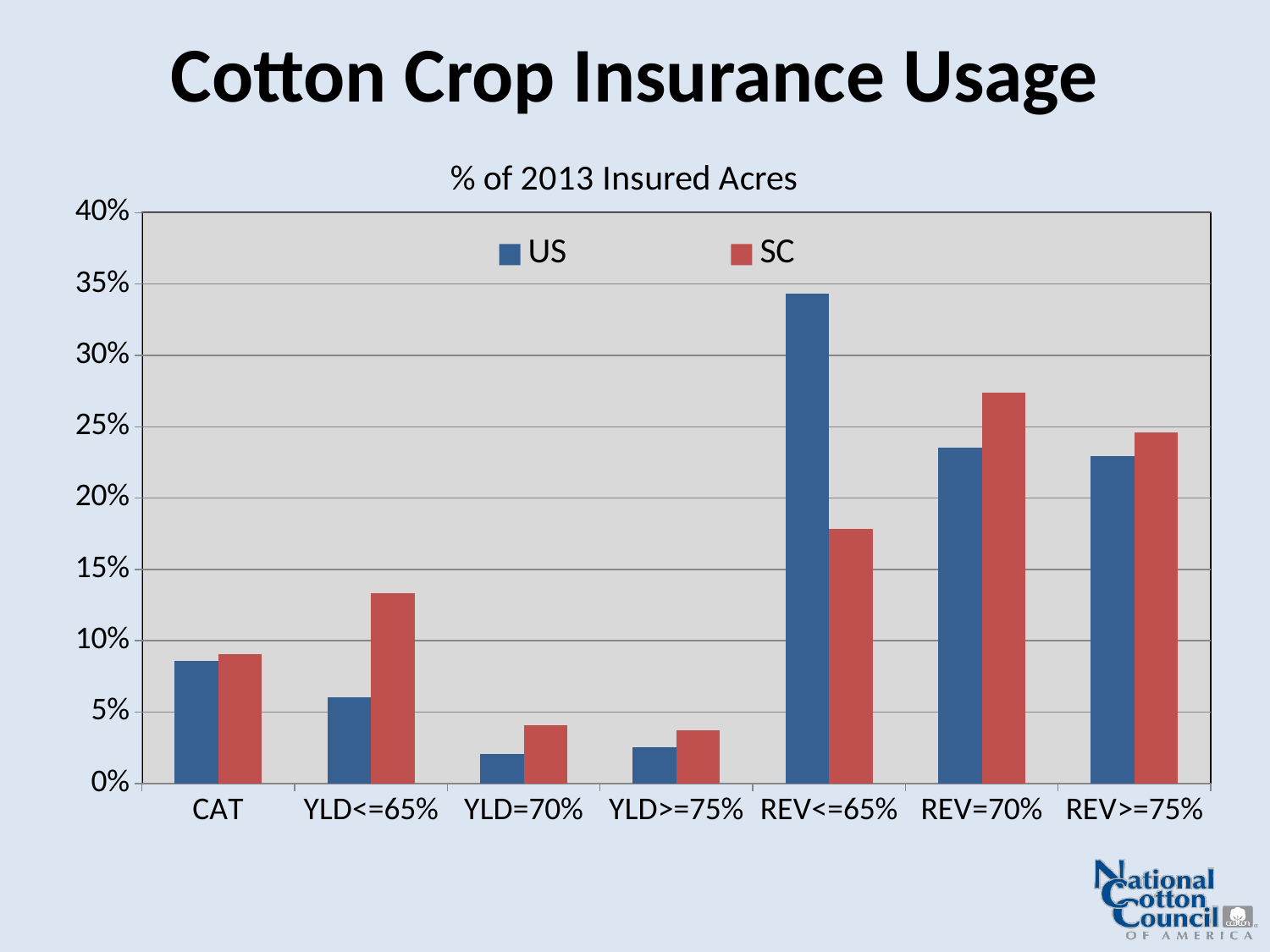
Which category has the highest US value? REV<=65% Is the SC value for REV<=65% greater or less than 20%? less Is the US value for REV<=65% greater or less than 30%? greater What is the subtitle shown above the chart? % of 2013 Insured Acres How many categories are shown on the x axis? 7 What kind of chart is shown on the slide? bar chart Is the SC value for REV=70% greater or less than 25%? greater For YLD<=65%, which is larger, the US value or the SC value? SC For REV<=65%, which is larger, the US value or the SC value? US Which category has the highest SC value? REV=70% Which category has the lowest US value? YLD=70% How many series does the legend list? 2